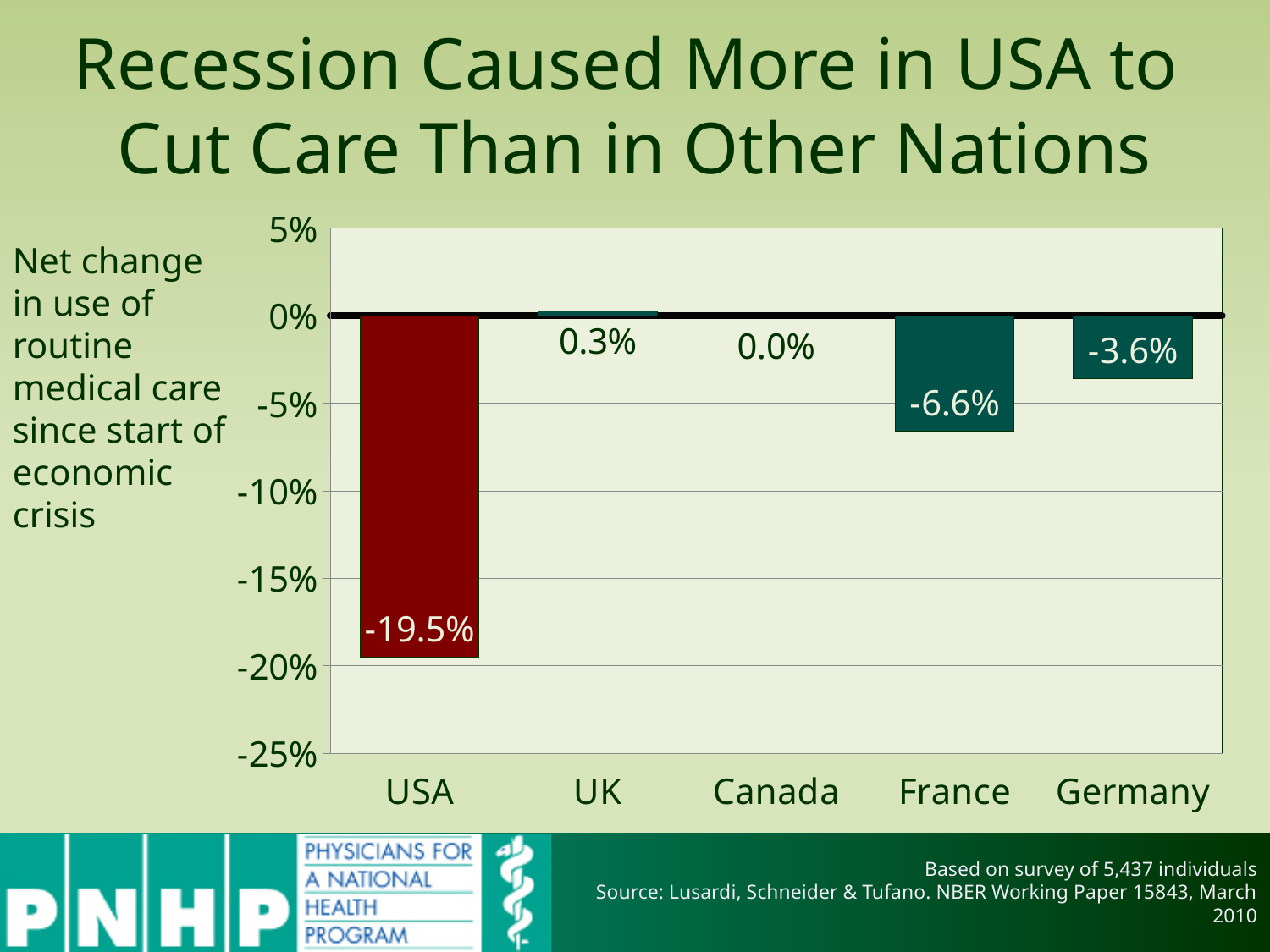
What kind of chart is shown on the slide? Bar chart How many countries are shown in the chart? 5 Which country has a larger decline in use of routine medical care, France or Germany? France What is the net change in use of routine medical care for the UK? 0.3% Which country shows the highest net change in use of routine medical care? UK Which country shows the largest decline in use of routine medical care? USA Which country's bar is shown in a different colour (dark red) from the others? USA What is the net change in use of routine medical care for Germany? -3.6% What is the net change in use of routine medical care for France? -6.6% What is the net change in use of routine medical care for the USA? -19.5% What is the title of the slide? Recession Caused More in USA to Cut Care Than in Other Nations What is the difference between the net change for the USA and for France? 12.9 percentage points